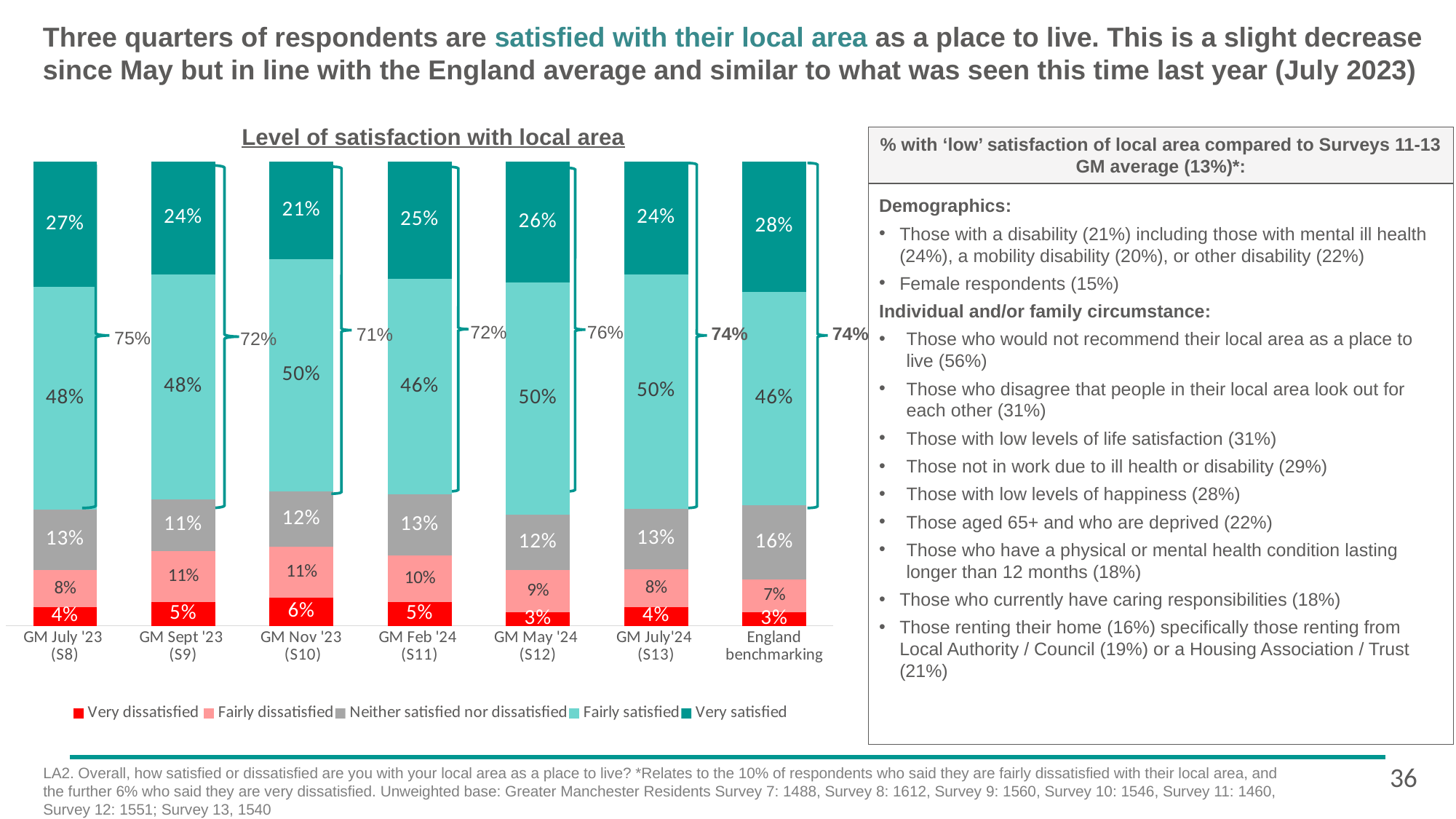
What is the 'Neither satisfied nor dissatisfied' value for England benchmarking? 16% Which category has the highest 'Very satisfied' percentage? England benchmarking What is the combined 'Fairly satisfied' and 'Very satisfied' total shown for GM July'24 (S13)? 74% Which category has the lowest 'Very satisfied' percentage? GM Nov '23 (S10) What is the difference between the 'Very dissatisfied' values for GM Nov '23 (S10) and GM May '24 (S12)? 3% How many categories are shown on the x axis of the chart? 7 What is the title of the chart? Level of satisfaction with local area Which is larger: the 'Fairly satisfied' value for GM Feb '24 (S11) or for GM May '24 (S12)? GM May '24 (S12) What percentage of respondents were 'Fairly dissatisfied' in GM Sept '23 (S9)? 11% What percentage of respondents were 'Very satisfied' in GM July '23 (S8)? 27% What kind of chart is shown on the slide? Stacked bar chart How many series does the legend list? 5